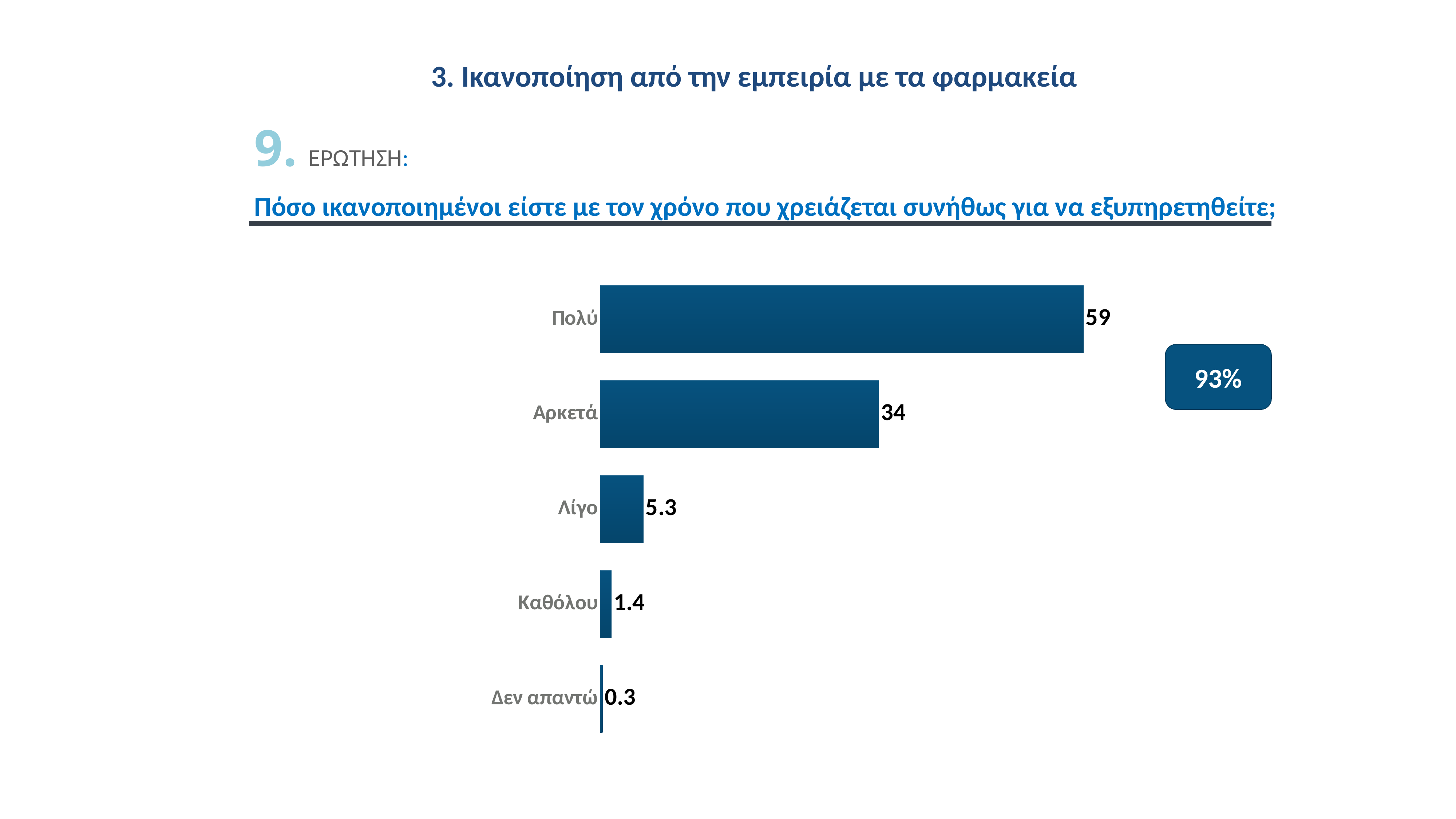
What is the value for Πολύ? 59 Which is larger, the value for Λίγο or the value for Καθόλου? Λίγο Which category has the lowest value? Δεν απαντώ What is the value for Λίγο? 5.3 What is the value for Καθόλου? 1.4 What is the value for Αρκετά? 34 What is the difference between the values for Πολύ and Αρκετά? 25 What percentage is shown in the rounded box to the right of the chart? 93% What is the value for Δεν απαντώ? 0.3 How many categories are shown in the chart? 5 What kind of chart is shown on the slide? Bar chart Which category has the highest value? Πολύ